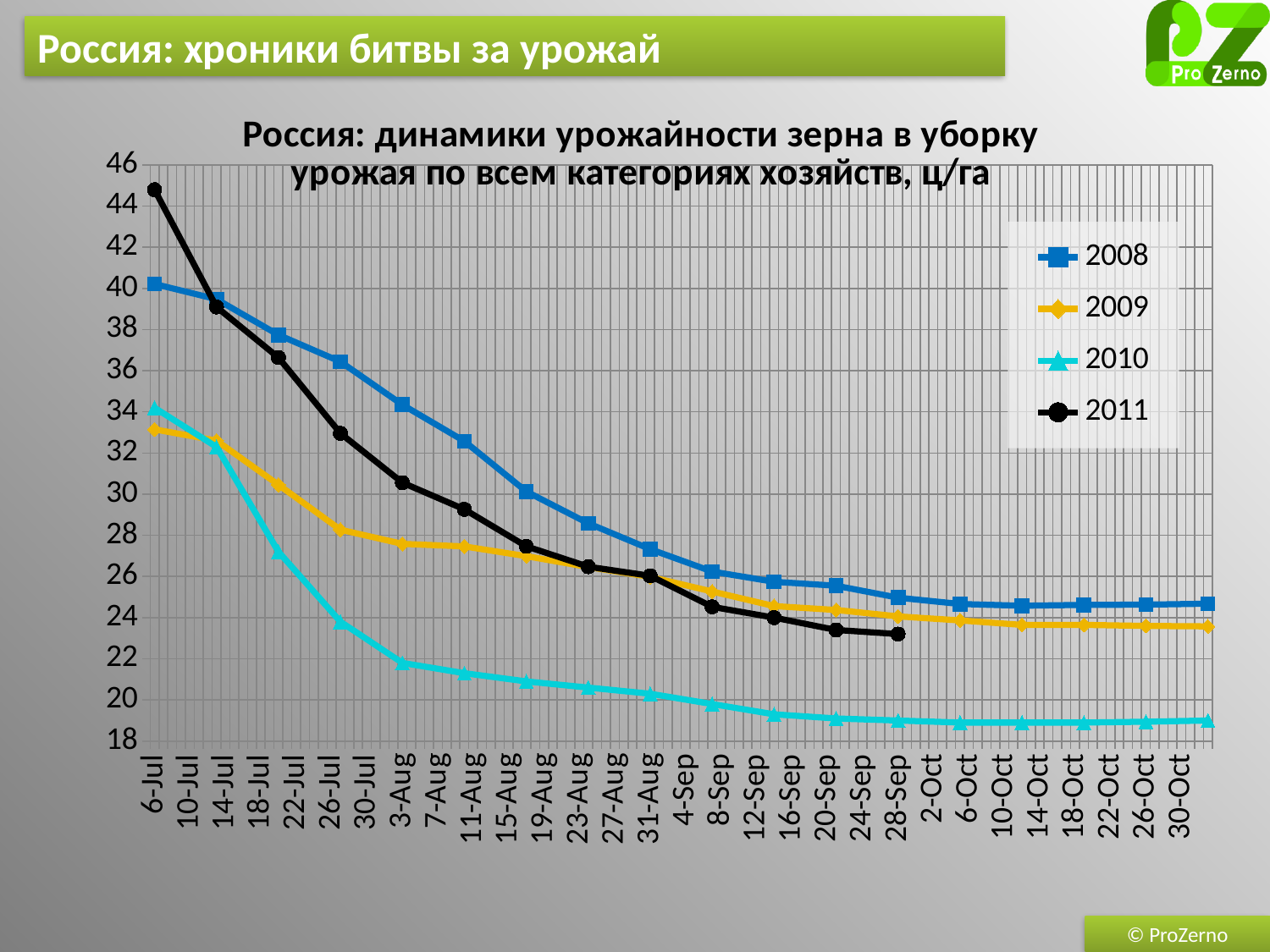
Is the value for 2010 at 30-Oct greater or less than 20? less What kind of chart is shown on the slide? line chart Do the values of the 2011 series rise or fall from 6-Jul to 28-Sep? fall Which series has the lowest value at 6-Jul? 2009 At 3-Aug, which is larger: the value for 2011 or the value for 2009? 2011 Is the value for 2011 at 6-Jul greater or less than 42? greater At 30-Oct, which is larger: the value for 2008 or the value for 2010? 2008 How many series does the legend list? 4 Which years are listed in the legend? 2008, 2009, 2010, 2011 Which series has the highest value at 6-Jul? 2011 Is the value for 2011 at 28-Sep greater or less than 24? less Which series has the lowest value at 30-Oct? 2010